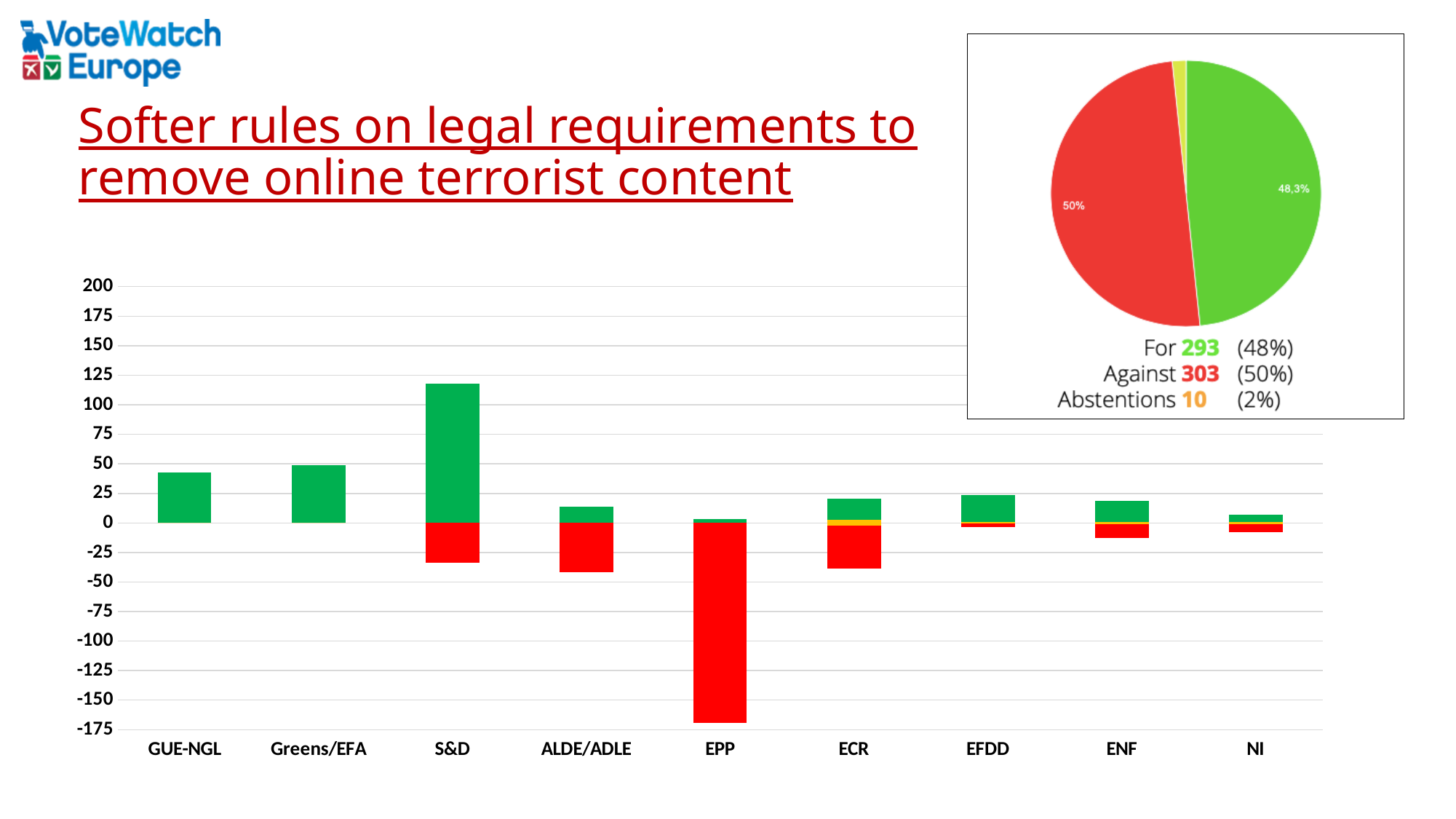
What kind of chart is the large chart at the bottom left of the slide? bar chart On the bar chart, which group has the tallest green (positive) bar? S&D On the pie chart, what is the difference between the Against and For vote counts? 10 On the bar chart, is the red value for EPP greater or less than -150? less On the bar chart, how many political groups are shown on the x axis? 9 On the bar chart, is the green value for S&D greater or less than 100? greater On the bar chart, is the green value for Greens/EFA greater or less than 25? greater What kind of chart is shown in the top right box of the slide? pie chart On the pie chart, how many votes were cast For? 293 On the bar chart, which has the taller green bar, GUE-NGL or S&D? S&D On the bar chart, which group has the largest red (negative) bar? EPP On the pie chart, what share of the votes were Against? 50%